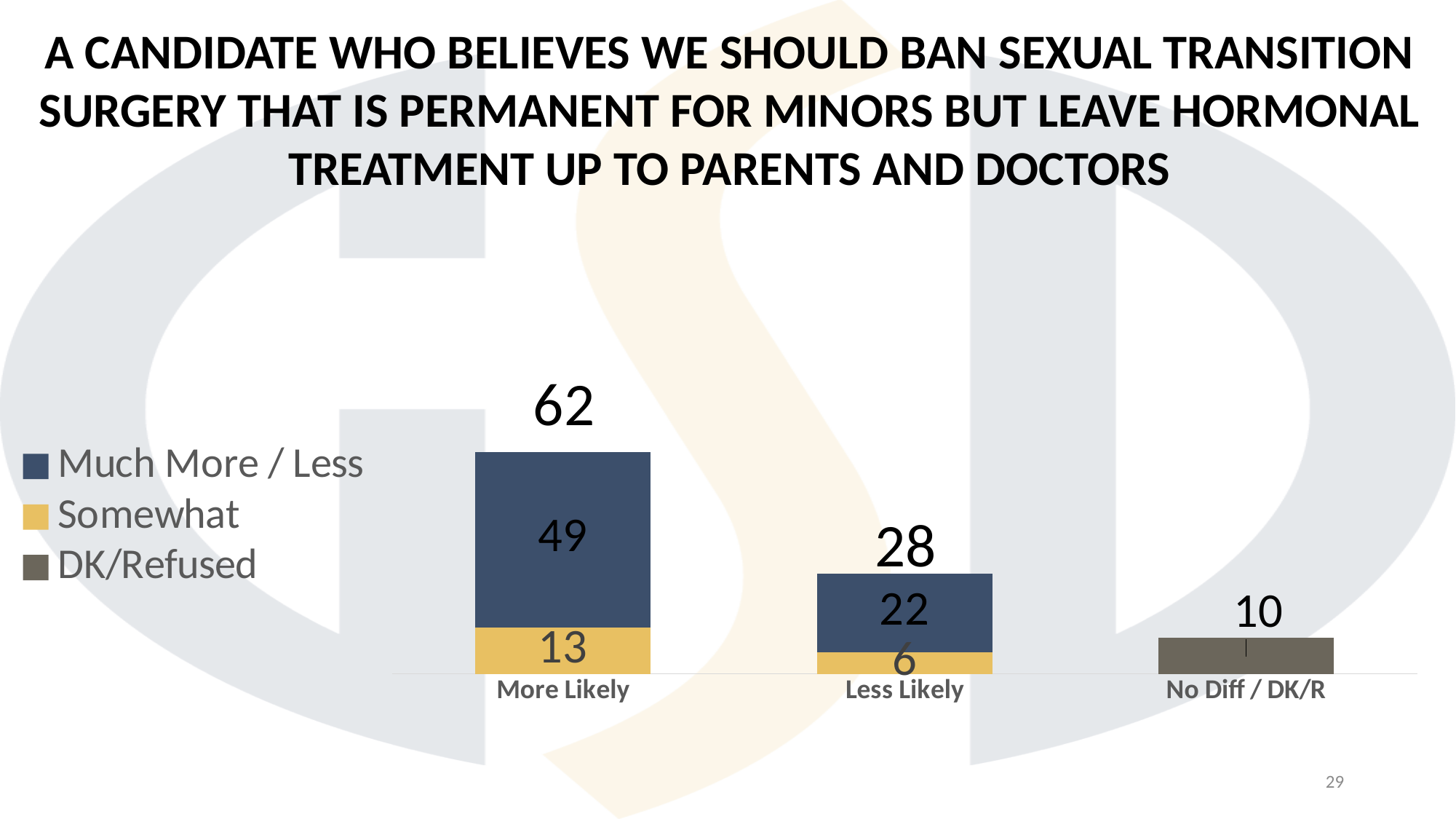
What is the 'Much More / Less' value for the More Likely bar? 49 What is the total shown above the Less Likely bar? 28 Which is larger: the 'Somewhat' value for More Likely or for Less Likely? More Likely What kind of chart is this? Stacked bar chart What is the 'Somewhat' value for the Less Likely bar? 6 Which category has the highest total? More Likely What is the value for No Diff / DK/R? 10 What is the total shown above the More Likely bar? 62 Which category has the lowest total? No Diff / DK/R How many categories are shown on the x axis? 3 What is the difference between the More Likely total and the Less Likely total? 34 How many series does the legend list? 3